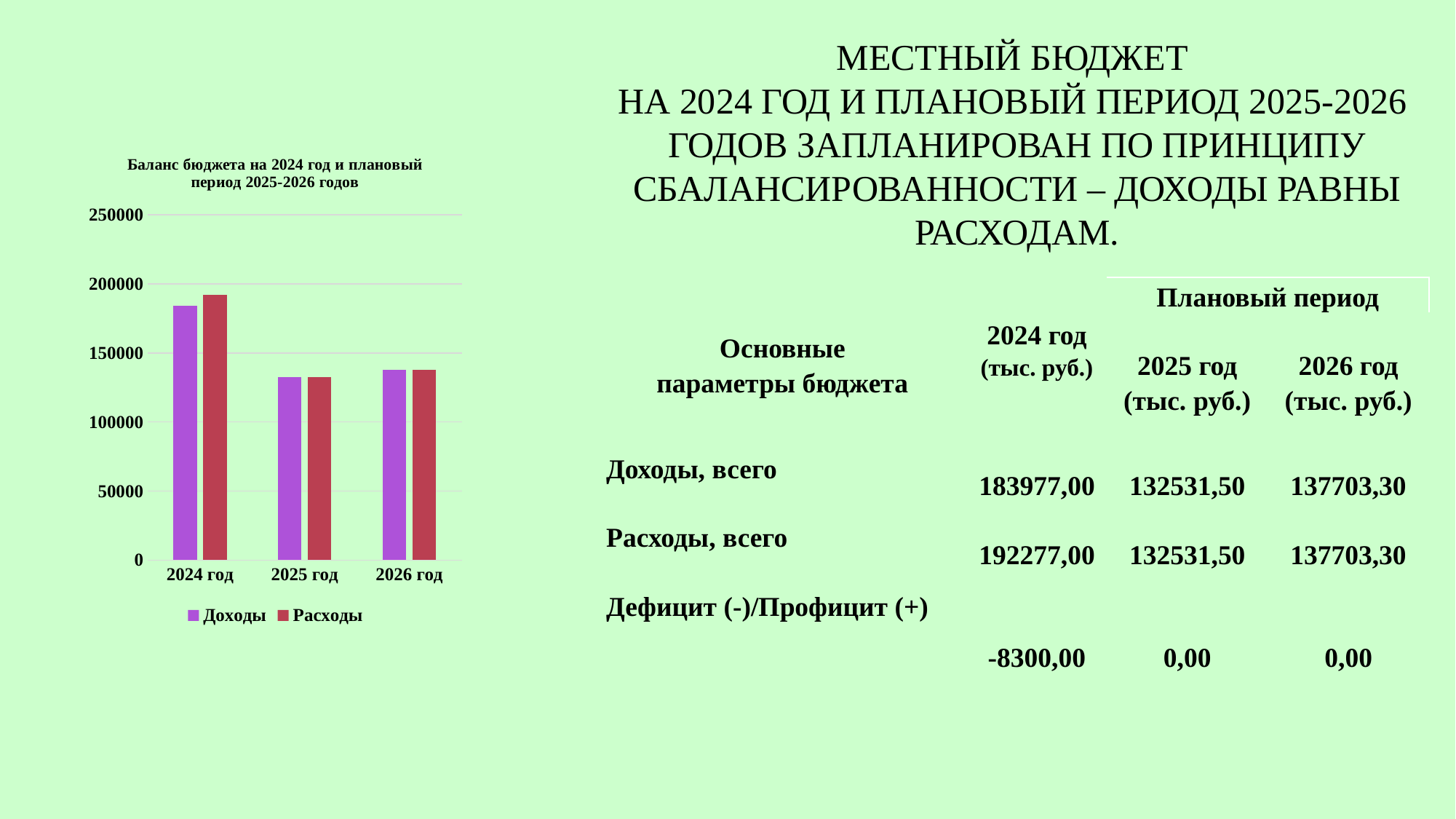
Do the Доходы values rise or fall from 2024 год to 2025 год? fall In which year is the Доходы bar the highest? 2024 год Is the Доходы value for 2025 год greater or less than 150000? less What is the title of the chart? Баланс бюджета на 2024 год и плановый период 2025-2026 годов How many year categories are shown on the x axis of the chart? 3 In which year is the Расходы bar the highest? 2024 год Which colour represents Доходы in the chart? purple Is the Доходы value for 2024 год greater or less than 150000? greater For 2024 год, which is larger, Доходы or Расходы? Расходы How many series does the chart legend list? 2 What kind of chart is shown on the left of the slide? bar chart Is the Расходы value for 2024 год greater or less than 200000? less